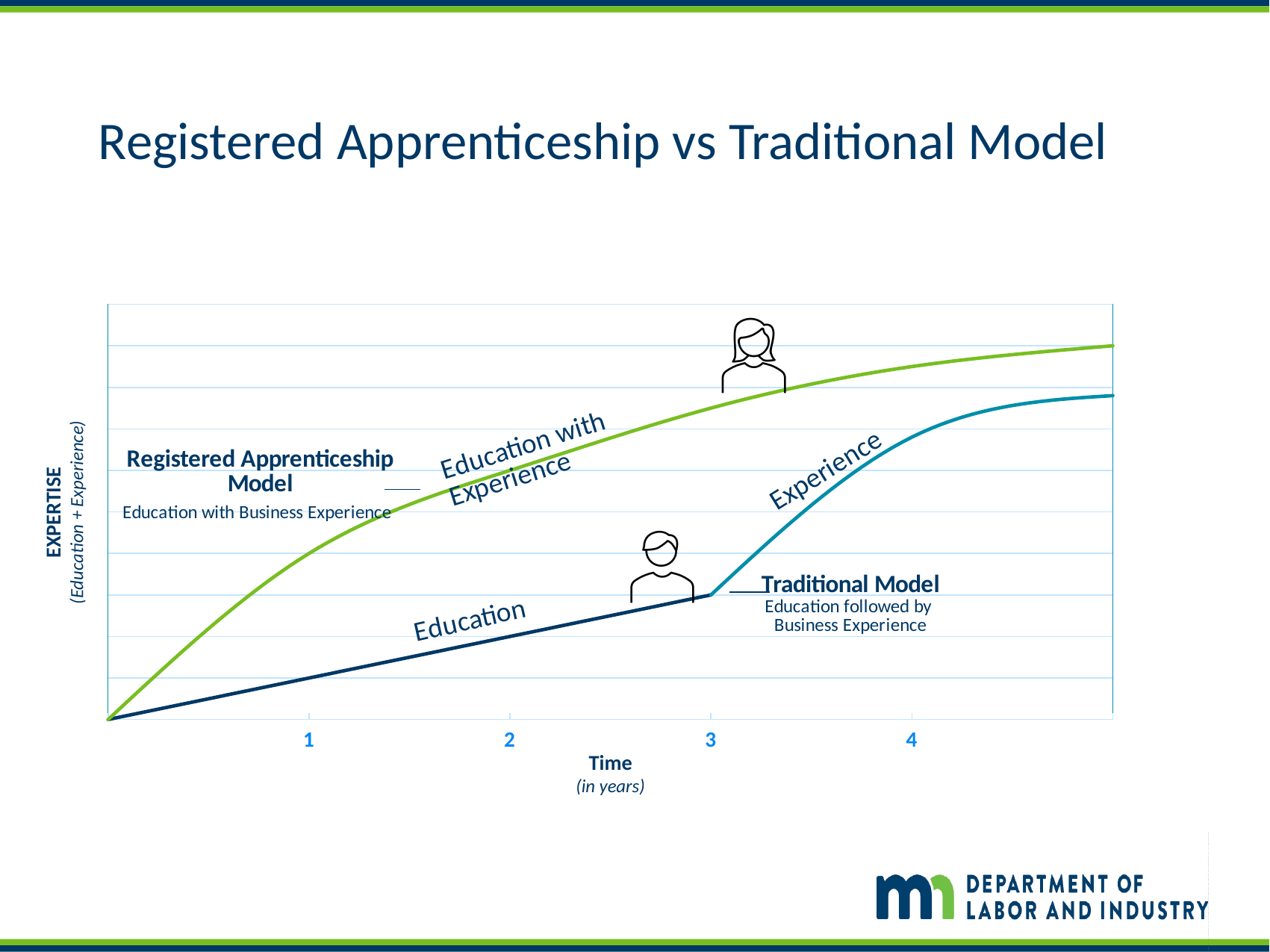
What is the label of the x axis? Time (in years) Which model's line is labelled "Education with Experience"? Registered Apprenticeship Model At which year does the Traditional Model line switch from the Education segment to the Experience segment? 3 At year 1, which line is higher: the Registered Apprenticeship Model or the Traditional Model? Registered Apprenticeship Model Does the Traditional Model line rise or fall as time increases? Rise How many model lines are plotted on the chart? 2 What kind of chart is shown on the slide? Line chart What is the title of the slide's chart? Registered Apprenticeship vs Traditional Model Does the Registered Apprenticeship Model line rise or fall as time increases? Rise Which model reaches the highest expertise at the right end of the chart? Registered Apprenticeship Model How many numbered tick marks are shown on the x axis? 4 At year 3, which model shows higher expertise: the Registered Apprenticeship Model or the Traditional Model? Registered Apprenticeship Model